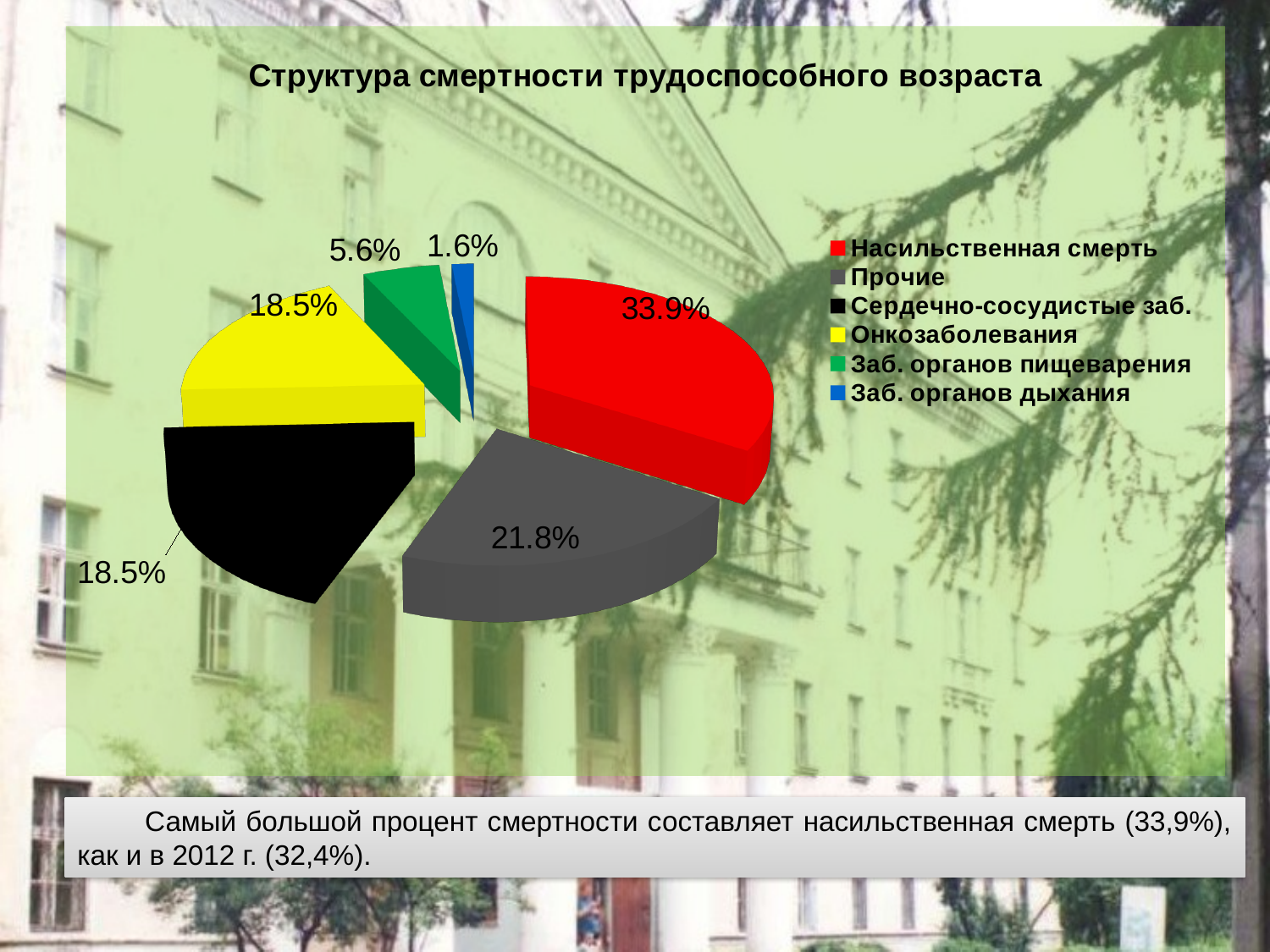
What share of the pie is Прочие? 21.8% What share of the pie is Заб. органов пищеварения? 5.6% Which category has the smallest slice of the pie? Заб. органов дыхания What share of the pie is Онкозаболевания? 18.5% What share of the pie is Заб. органов дыхания? 1.6% How many categories does the legend list? 6 What type of chart is shown on the slide? Pie chart What share of the pie is Насильственная смерть? 33.9% What is the difference between the shares of Насильственная смерть and Прочие? 12.1% What is the title of the chart? Структура смертности трудоспособного возраста Which colour represents Сердечно-сосудистые заб. in the chart? Black Which category has the largest slice of the pie? Насильственная смерть